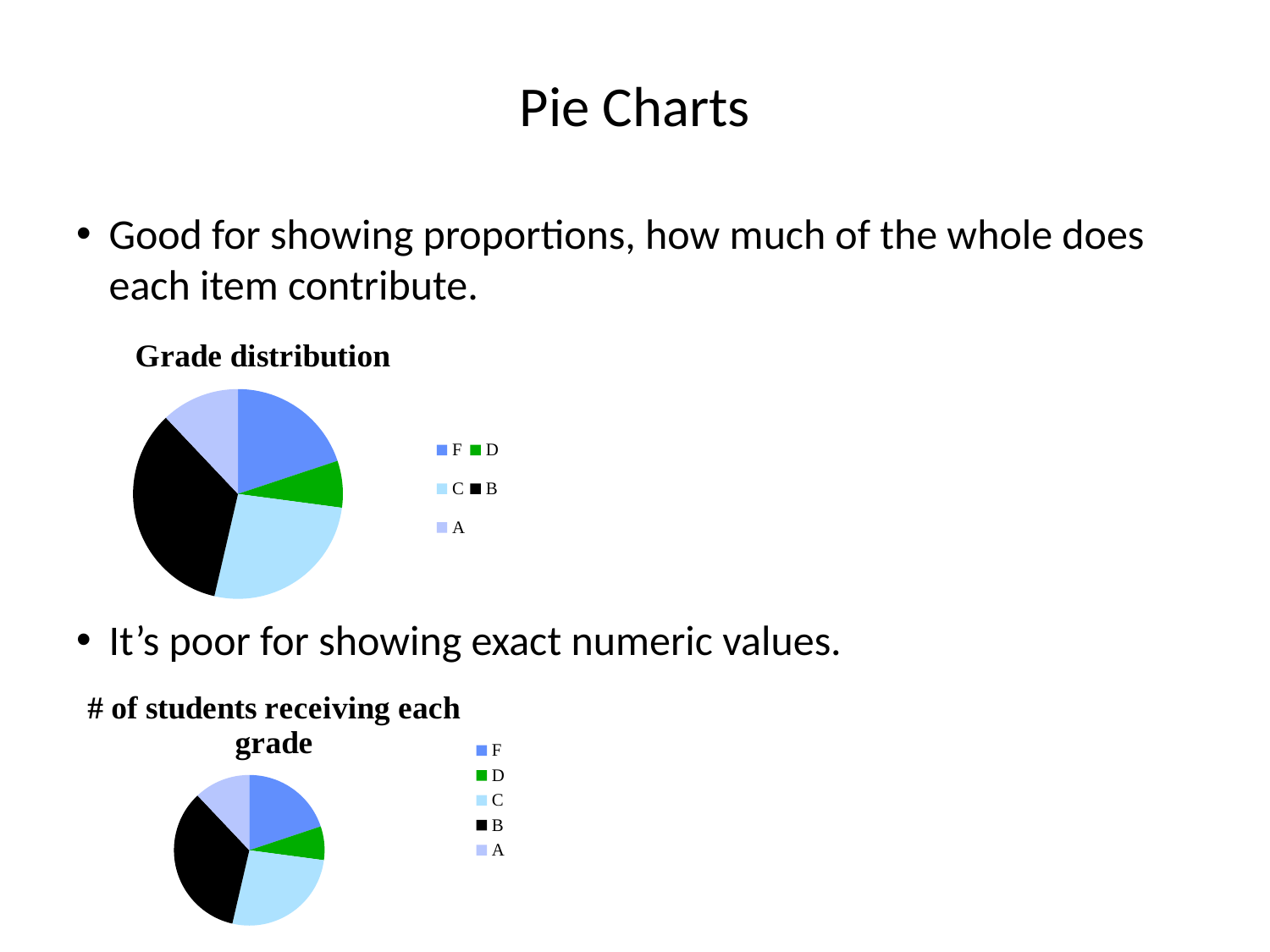
In the "Grade distribution" chart, which grade has the smallest slice? D In the "Grade distribution" chart, which grade has the largest slice? B In the "# of students receiving each grade" chart, which grade has the smallest slice? D What is the title of the top pie chart on the slide? Grade distribution In the "Grade distribution" chart, how many slices does the pie have? 5 What kind of chart is the "Grade distribution" chart? pie chart In the "# of students receiving each grade" chart, which slice is larger, B or A? B What kind of chart is the "# of students receiving each grade" chart? pie chart In the "Grade distribution" chart, which slice is larger, C or D? C In the "# of students receiving each grade" chart, which grade has the largest slice? B In the "# of students receiving each grade" chart, how many entries does the legend list? 5 In the "Grade distribution" chart, what colour is the slice for grade B? black